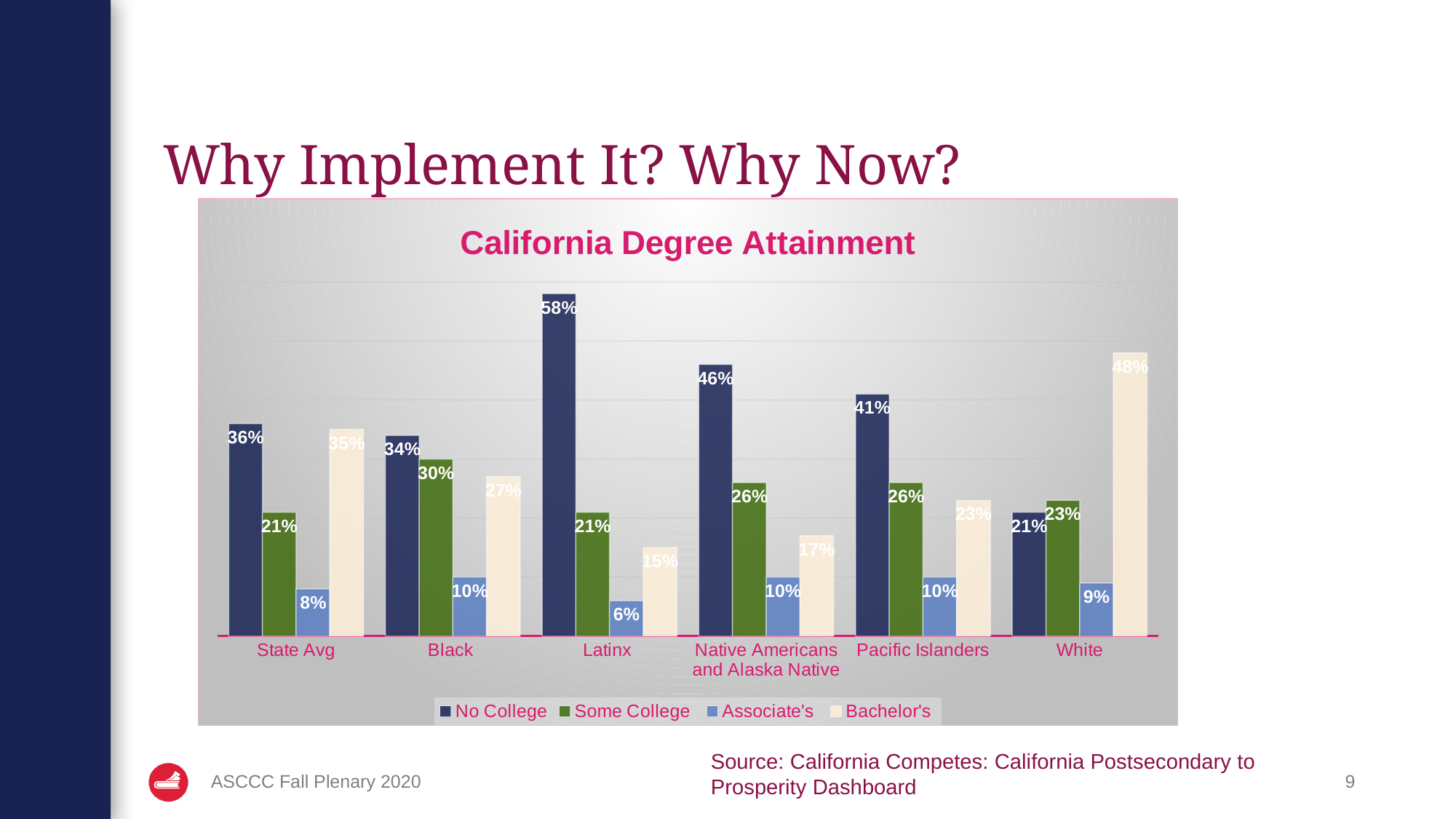
What kind of chart is shown? Bar chart What is the Some College value for Native Americans and Alaska Native? 26% What is the Associate's value for Black? 10% What is the title of the chart? California Degree Attainment Which category has the highest No College value? Latinx Which category has the lowest Bachelor's value? Latinx What is the difference between the Bachelor's values for White and State Avg? 13% What is the Bachelor's value for White? 48% What is the No College value for Latinx? 58% How many categories are shown on the x axis? 6 How many series does the legend list? 4 Which is larger, the Some College value for Black or for Pacific Islanders? Black